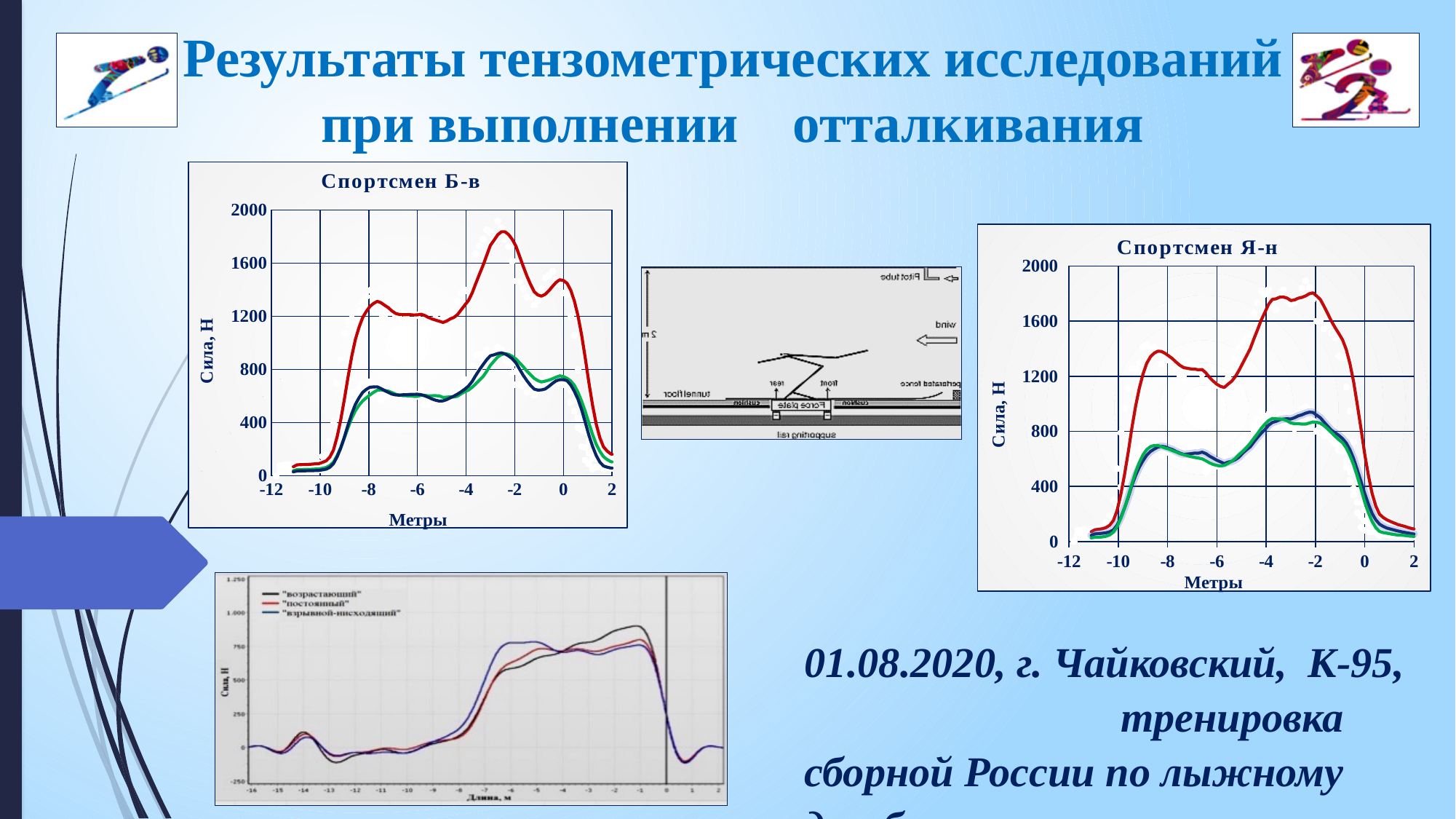
How many series does the legend of the bottom-left chart list? 3 In the chart titled "Спортсмен Б-в", what is the label of the horizontal axis? Метры In the chart titled "Спортсмен Б-в", is the highest value of the green line greater or less than 1200? less In the chart titled "Спортсмен Я-н", what is the maximum value shown on the vertical axis? 2000 In the chart titled "Спортсмен Б-в", is the highest value of the red line greater or less than 1600? greater What kind of chart is the chart titled "Спортсмен Б-в"? line chart What kind of chart is the bottom-left chart? line chart In the chart titled "Спортсмен Я-н", is the highest value of the red line greater or less than 1600? greater In the chart titled "Спортсмен Б-в", which line reaches the highest value: the red line or the green line? the red line In the chart titled "Спортсмен Б-в", what is the label of the vertical axis? Сила, Н